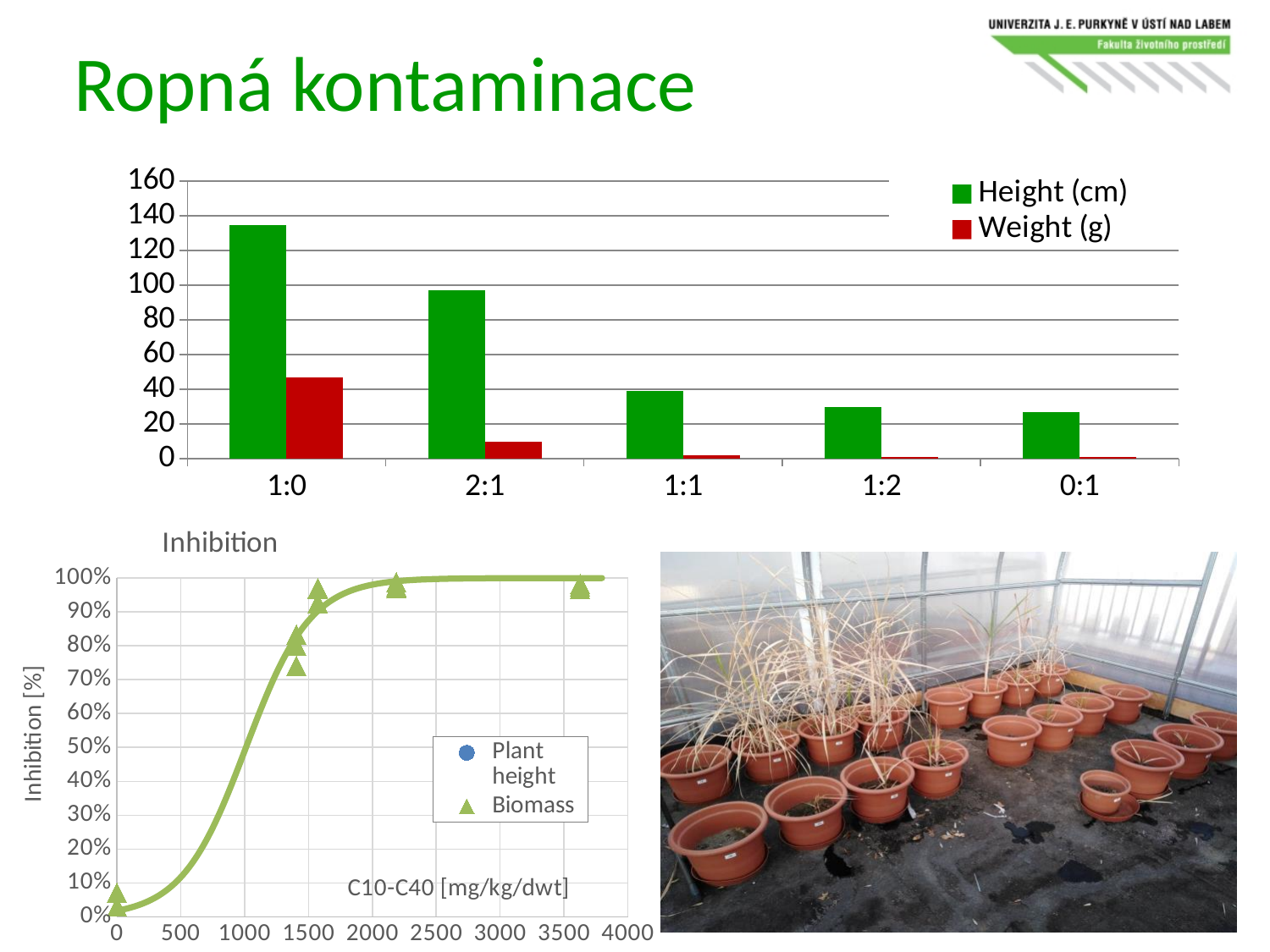
On the top bar chart, which is larger: the Height (cm) value for 2:1 or the Height (cm) value for 1:1? 2:1 On the top bar chart, is the Height (cm) value for 2:1 greater or less than 100? less On the top bar chart, which category has the highest Height (cm) value? 1:0 On the top bar chart, is the Height (cm) value for 1:0 greater or less than 120? greater On the top bar chart, which category has the highest Weight (g) value? 1:0 How many categories are shown on the x axis of the top bar chart? 5 Do the Height (cm) values on the top bar chart rise or fall from left to right along the x axis? fall On the top bar chart, is the Weight (g) value for 1:0 greater or less than 40? greater What is the title of the bottom-left chart? Inhibition On the Inhibition chart, does the Biomass inhibition rise or fall as C10-C40 concentration increases? rise How many series does the legend of the top bar chart list? 2